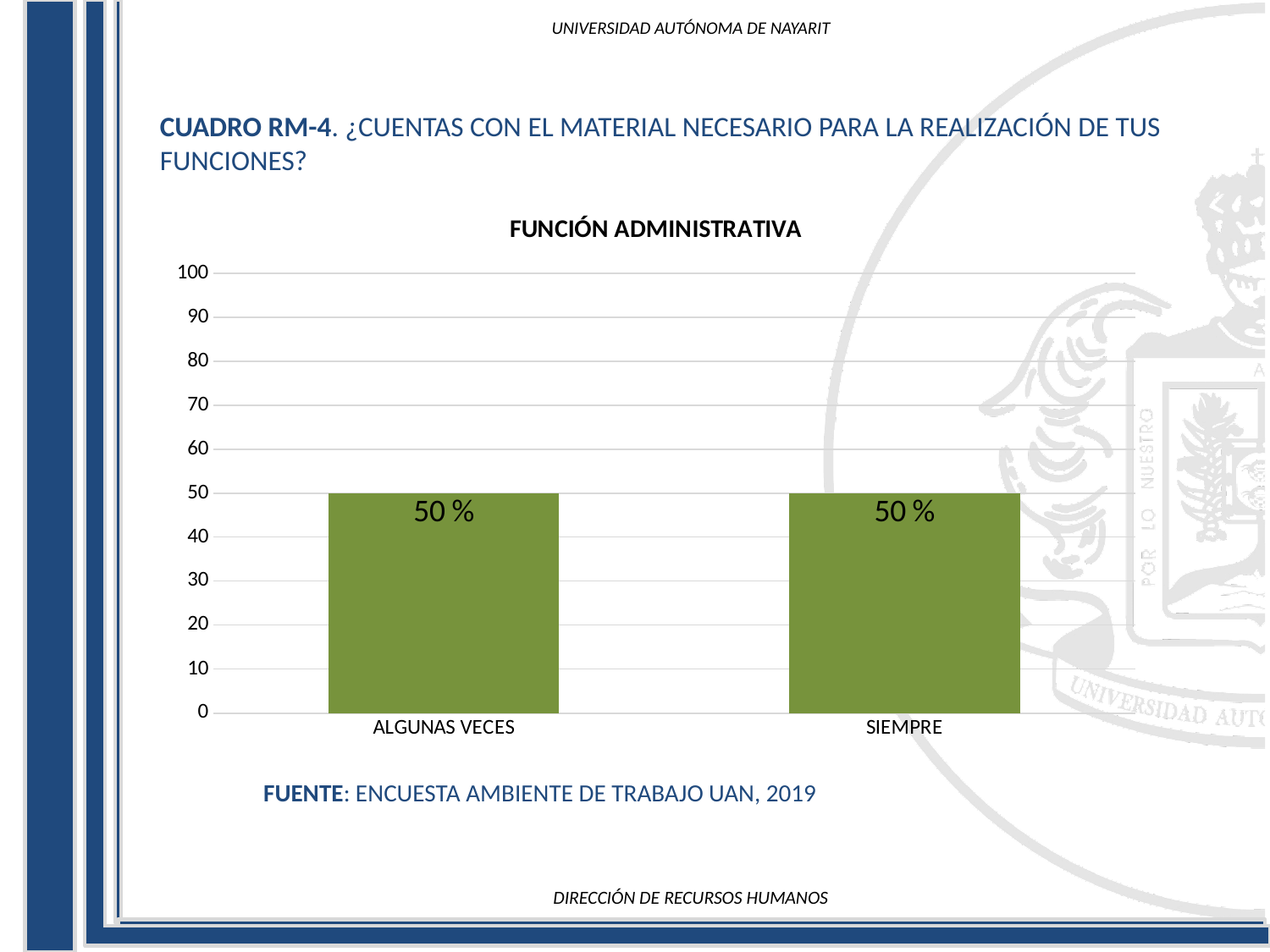
What is the highest value shown on the vertical axis? 100 Is the value for SIEMPRE greater or less than 80? less What is the title of the chart? FUNCIÓN ADMINISTRATIVA What kind of chart is shown on the slide? bar chart How many categories are shown on the x axis? 2 What is the difference between the values for ALGUNAS VECES and SIEMPRE? 0 Is the value for ALGUNAS VECES greater or less than 20? greater What is the total of the values for ALGUNAS VECES and SIEMPRE? 100 % What is the value for ALGUNAS VECES? 50 % What is the value for SIEMPRE? 50 %